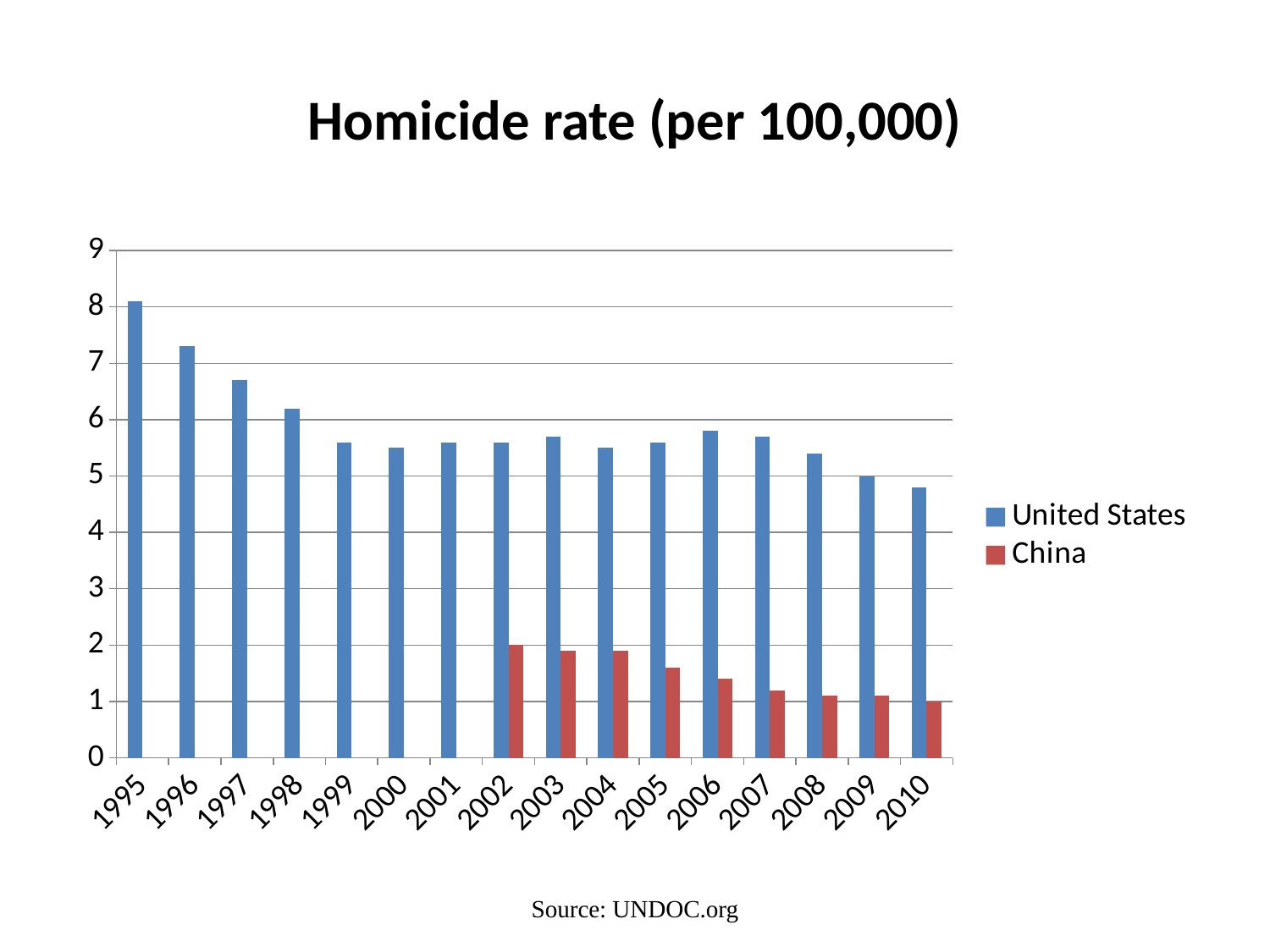
In which year is the United States homicide rate highest? 1995 In which year is the China homicide rate highest? 2002 Is the United States homicide rate in 1995 greater or less than 7? greater What is the title of the chart? Homicide rate (per 100,000) Is the China homicide rate in 2005 greater or less than 1? greater Does the United States homicide rate generally rise or fall from 1995 to 2010? fall Is the United States homicide rate in 2010 greater or less than 5? less In which year is the United States homicide rate lowest? 2010 Which is larger in 2005, the homicide rate for the United States or for China? United States How many years are shown on the x axis? 16 What kind of chart is shown on the slide? bar chart How many series does the legend list? 2